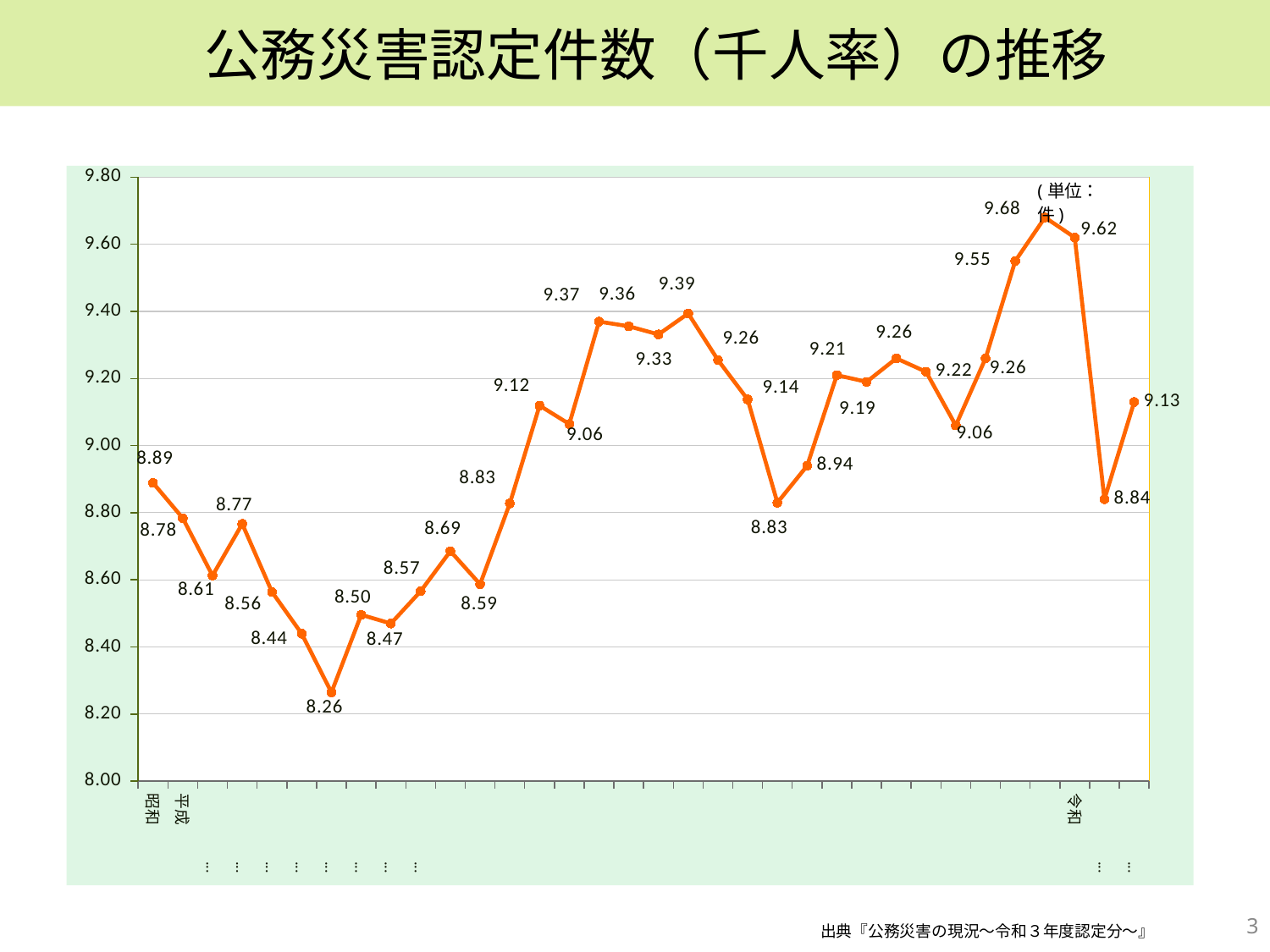
What is the value of the first (leftmost) data point on the chart? 8.89 What is the highest value plotted on the chart? 9.68 What is the difference between the highest value (9.68) and the lowest value (8.26) on the chart? 1.42 What is the difference between the last data point (9.13) and the one just before it (8.84)? 0.29 Comparing the first data point to the last data point, does the value rise or fall overall across the chart? rise Is the highest point on the chart greater or less than 9.60? greater What is the title of the chart? 公務災害認定件数（千人率）の推移 What is the lowest value plotted on the chart? 8.26 What kind of chart is shown on the slide? line chart What unit is indicated in the note at the top right of the chart? 件 What is the value of the last (rightmost) data point on the chart? 9.13 Which is larger, the first data point (8.89) or the last data point (9.13)? the last data point (9.13)